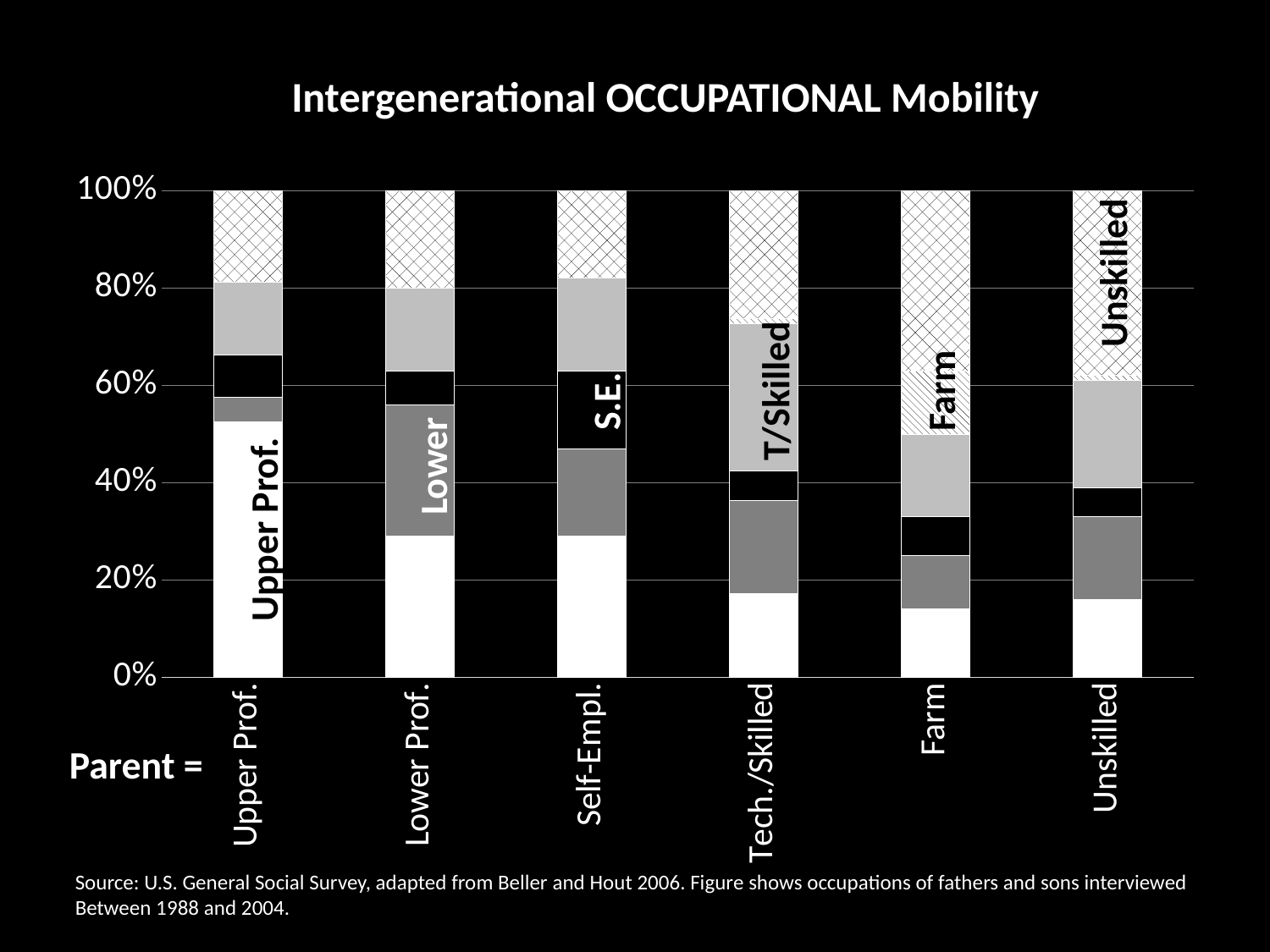
Is the white (Upper Prof.) segment for the Upper Prof. parent category greater or less than 40%? greater How many parent occupation categories are shown along the x axis? 6 What kind of chart is shown on the slide? Stacked bar chart Is the white (Upper Prof.) segment for the Tech./Skilled parent category greater or less than 20%? less What is the title of the chart? Intergenerational OCCUPATIONAL Mobility Which parent category has the largest white (Upper Prof.) segment? Upper Prof. What does each stacked bar total? 100% Is the white (Upper Prof.) segment for the Unskilled parent category greater or less than 20%? less Which has a larger white (Upper Prof.) segment: the Upper Prof. parent category or the Farm parent category? Upper Prof. What label appears to the left of the x-axis categories? Parent =